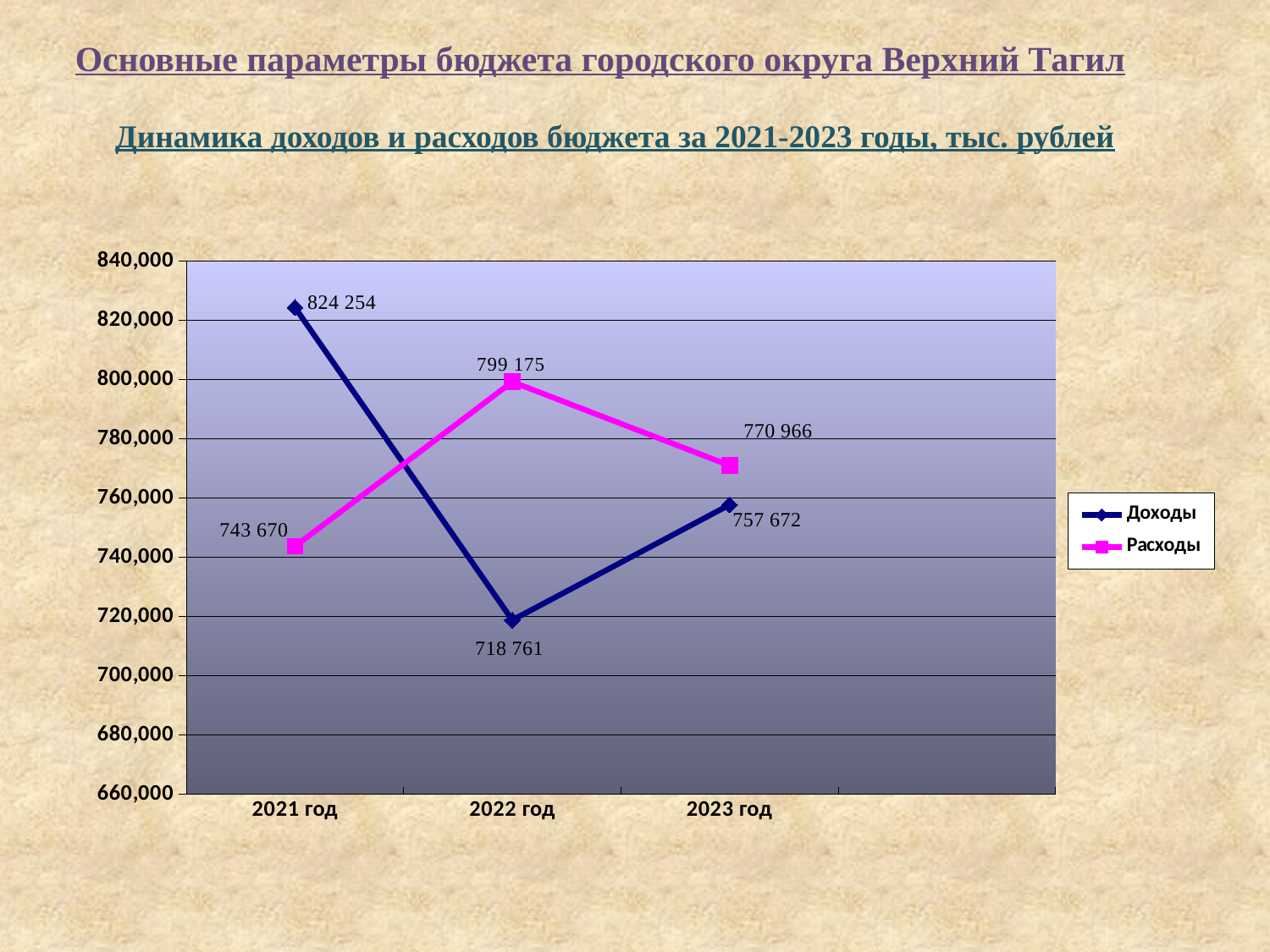
What is the value of Расходы for 2021 год? 743 670 In which year is Расходы the highest? 2022 год What is the value of Расходы for 2022 год? 799 175 What is the value of Доходы for 2021 год? 824 254 In which year is Доходы the lowest? 2022 год What is the value of Доходы for 2023 год? 757 672 What kind of chart is shown on the slide? Line chart What is the difference between Доходы and Расходы in 2021 год? 80 584 How many series does the legend list? 2 Does Расходы rise or fall from 2022 год to 2023 год? Fall What is the difference between Расходы and Доходы in 2023 год? 13 294 Which is larger in 2022 год, Доходы or Расходы? Расходы